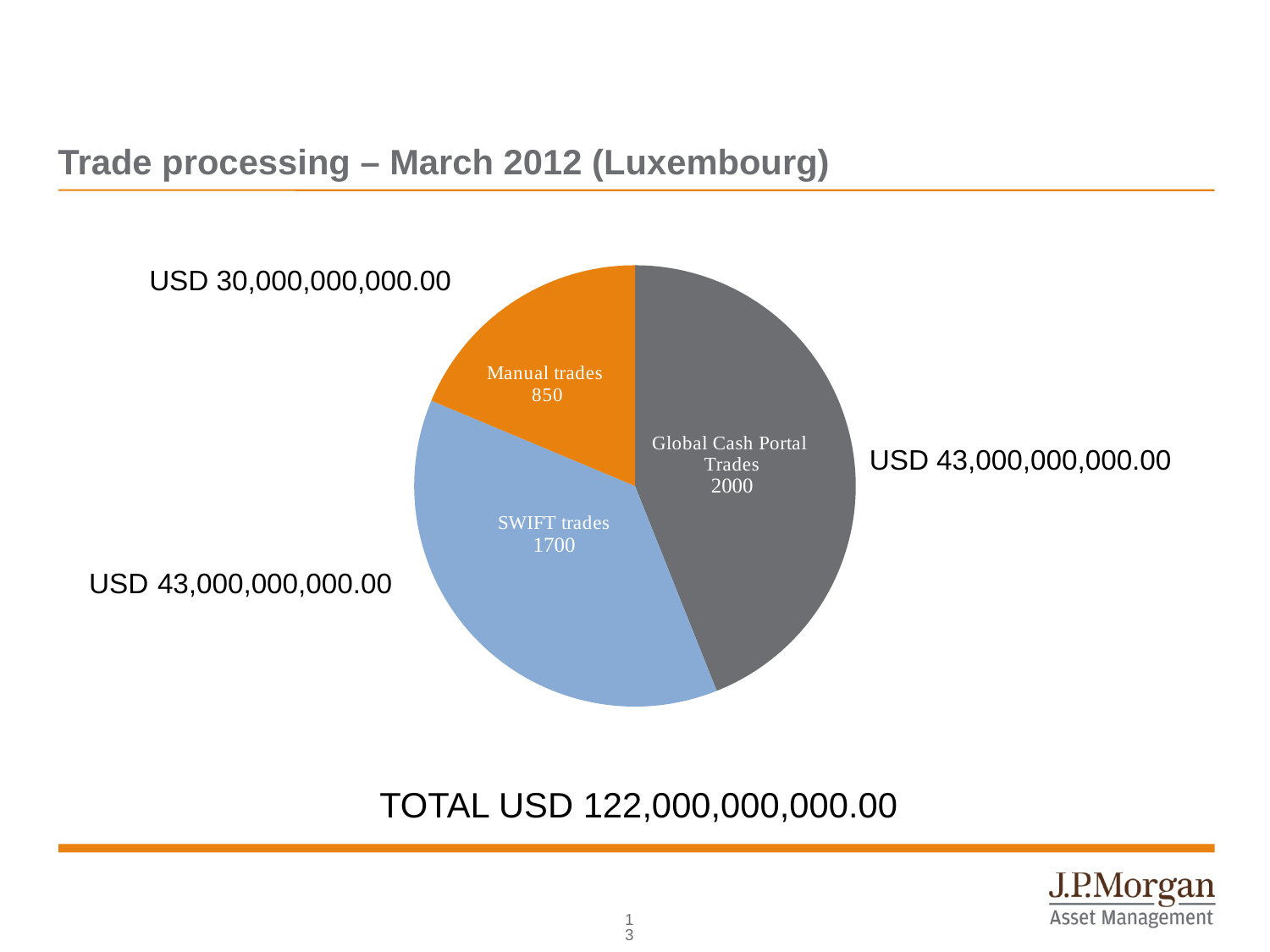
What is the title of the slide containing the pie chart? Trade processing – March 2012 (Luxembourg) Which category has the largest slice of the pie? Global Cash Portal Trades What is the difference between the Global Cash Portal Trades value and the SWIFT trades value? 300 What is the sum of the three slice values in the pie chart? 4550 What kind of chart is shown on the slide? pie chart What is the value shown for Manual trades? 850 What is the value shown for Global Cash Portal Trades? 2000 What is the difference between the SWIFT trades value and the Manual trades value? 850 Which category has the smallest slice of the pie? Manual trades What is the value shown for SWIFT trades? 1700 Which is larger, the value for SWIFT trades or the value for Manual trades? SWIFT trades How many slices does the pie chart have? 3